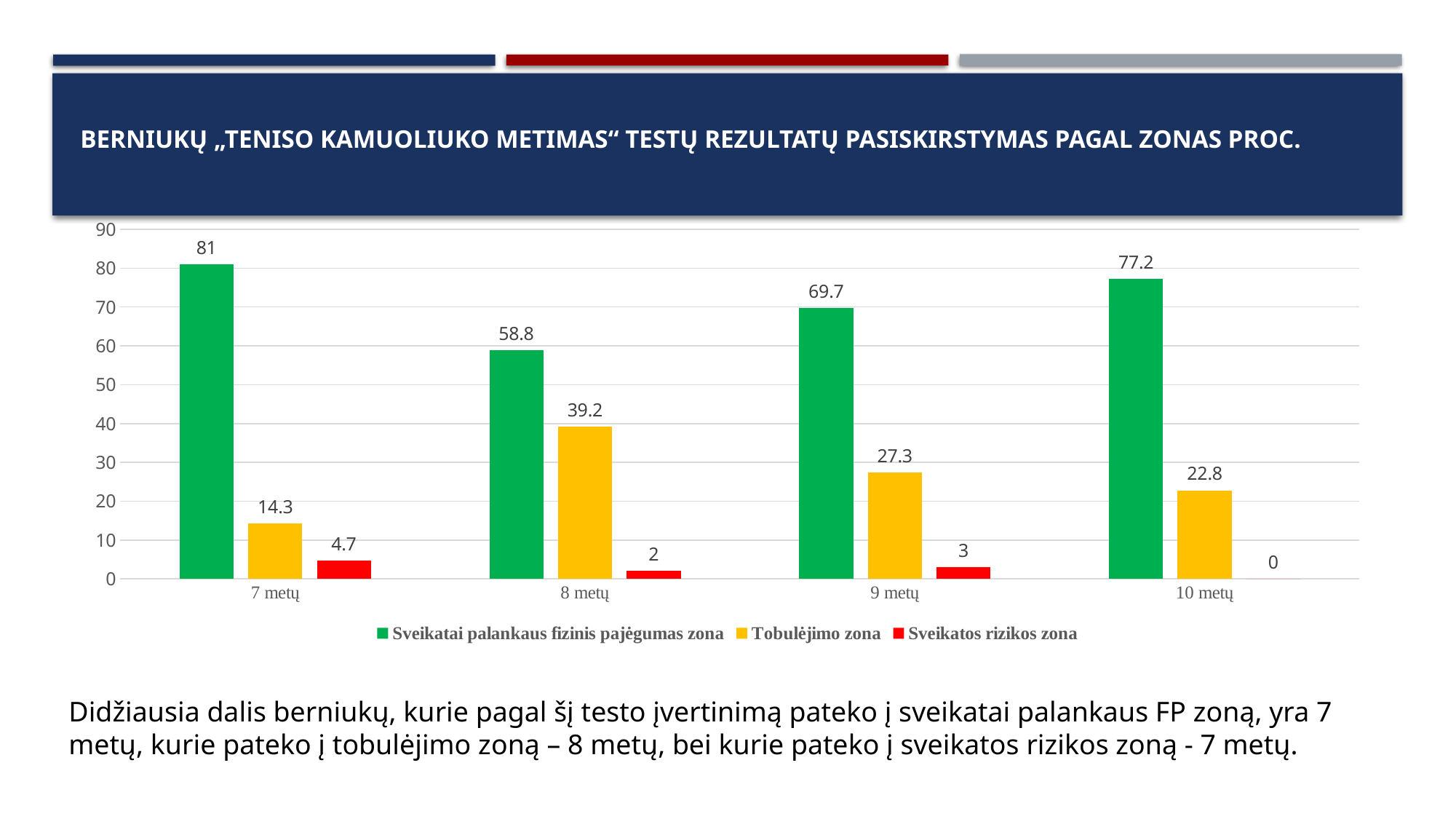
Which colour represents 'Sveikatos rizikos zona' in the chart? Red What is the value for 'Sveikatai palankaus fizinis pajėgumas zona' at 9 metų? 69.7 How many series does the legend list? 3 How many age groups are shown on the x axis? 4 What is the difference between the 'Tobulėjimo zona' values for 8 metų and 10 metų? 16.4 Which is larger: 'Sveikatos rizikos zona' at 7 metų or at 9 metų? 7 metų What is the value for 'Tobulėjimo zona' at 8 metų? 39.2 What kind of chart is shown on the slide? Bar chart Which age group has the highest value for 'Sveikatai palankaus fizinis pajėgumas zona'? 7 metų What is the value for 'Sveikatai palankaus fizinis pajėgumas zona' at 7 metų? 81 What is the value for 'Sveikatos rizikos zona' at 10 metų? 0 Which age group has the lowest value for 'Tobulėjimo zona'? 7 metų